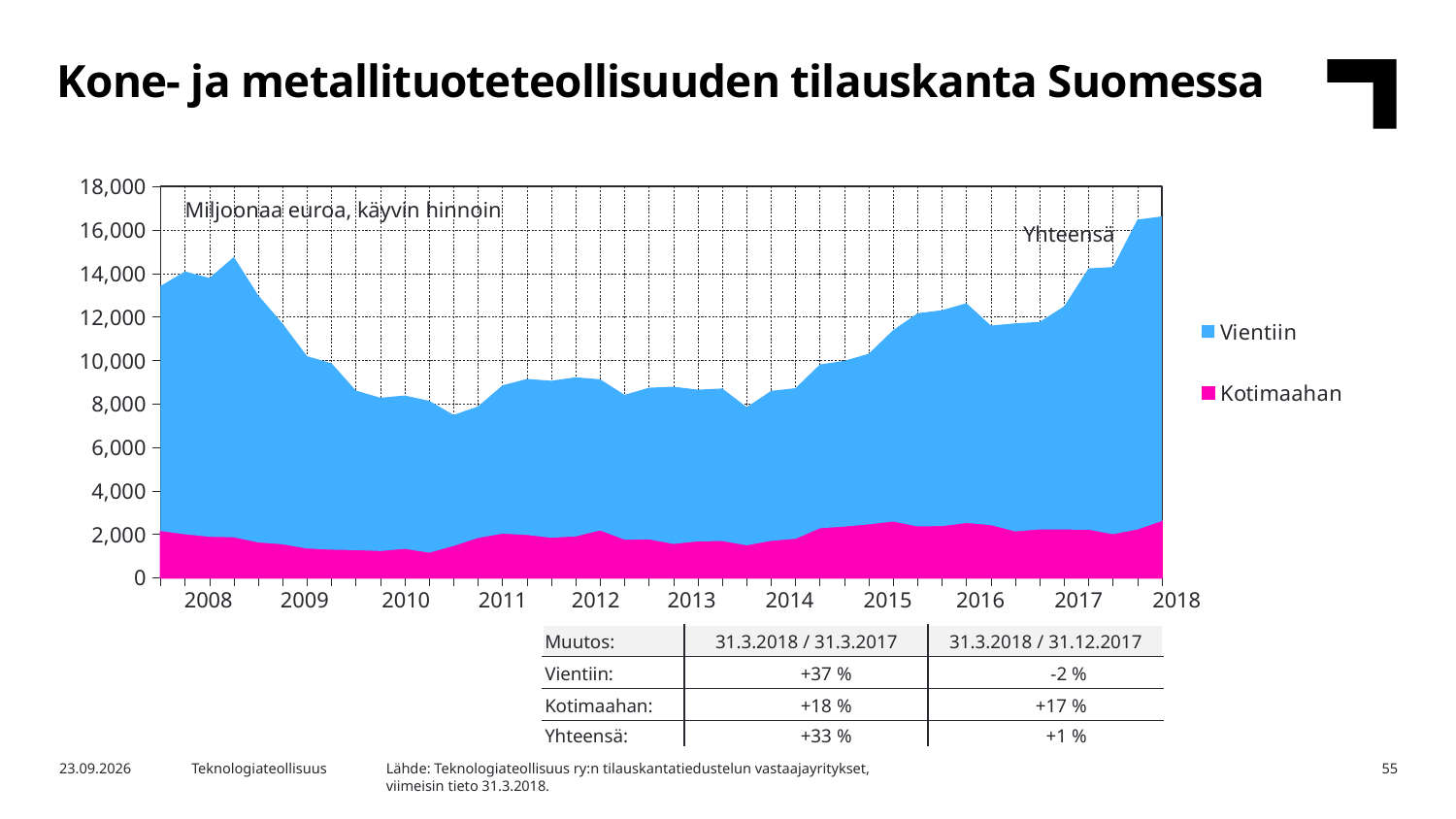
What type of chart is shown on the slide? Stacked area chart Is the Kotimaahan value at the end of the series in 2018 greater or less than 2,000? greater Which is larger, the total order book at the start of 2008 or at the start of 2013? 2008 Is the total (Yhteensä) value at the start of 2008 greater or less than 12,000? greater How many year labels are shown on the x axis? 11 Is the total (Yhteensä) value at the start of 2013 greater or less than 10,000? less What unit is stated in the annotation inside the chart area? Miljoonaa euroa, käyvin hinnoin Does the total order book rise or fall between 2008 and 2010? fall What are the two series named in the chart legend? Vientiin and Kotimaahan How many series does the chart legend list? 2